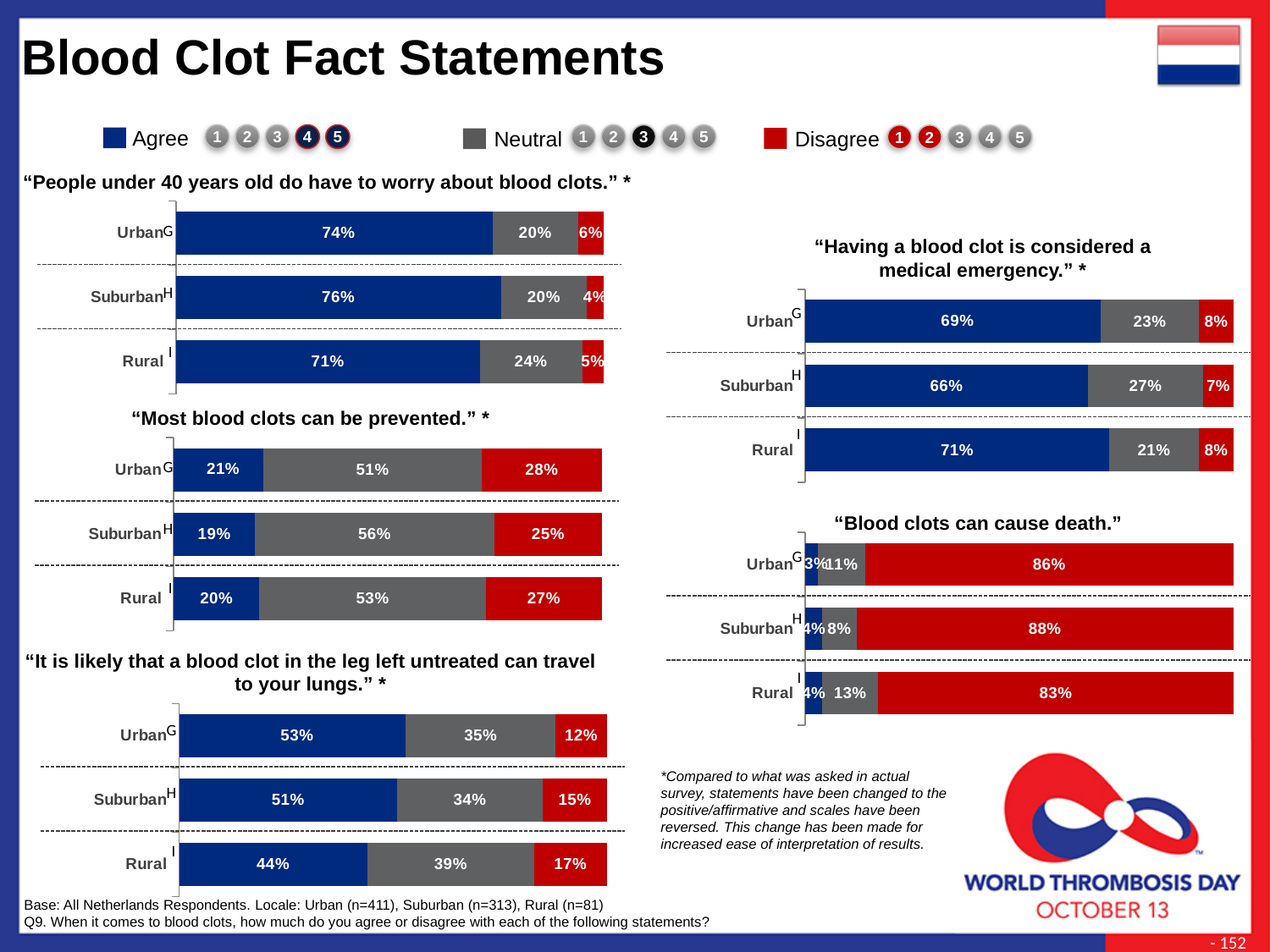
In the chart "Most blood clots can be prevented," is the Urban Disagree percentage larger or smaller than the Suburban Disagree percentage? larger In the chart "Having a blood clot is considered a medical emergency," what is the difference between the Suburban and Rural Neutral percentages? 6% In the chart "Having a blood clot is considered a medical emergency," which locale has the highest Agree percentage? Rural In the chart "It is likely that a blood clot in the leg left untreated can travel to your lungs," which locale has the lowest Agree percentage? Rural In the chart "People under 40 years old do have to worry about blood clots," what percentage of Suburban respondents agree? 76% How many series does the legend at the top of the slide list? 3 What type of chart is used for "People under 40 years old do have to worry about blood clots"? Stacked bar chart In the chart "Blood clots can cause death," what percentage of Suburban respondents disagree? 88% In the legend at the top of the slide, which colour represents Disagree? Red How many locale categories are shown in the chart "Blood clots can cause death"? 3 In the chart "It is likely that a blood clot in the leg left untreated can travel to your lungs," what is the difference between the Urban and Rural Agree percentages? 9% In the chart "Most blood clots can be prevented," what percentage of Suburban respondents are neutral? 56%